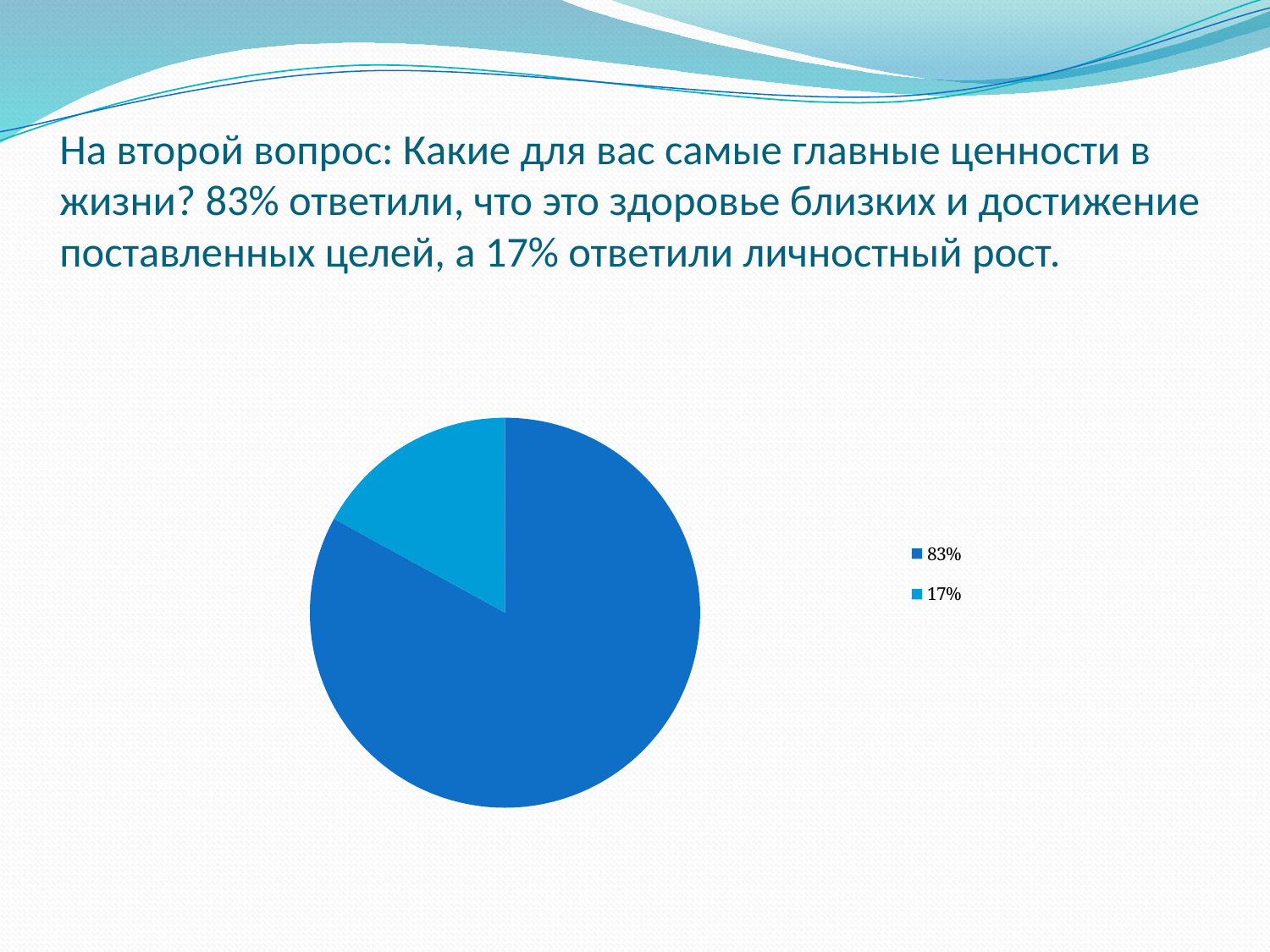
What kind of chart is shown on the slide? pie chart What share of the pie does the light blue slice represent, according to the legend? 17% Which legend entry corresponds to the smallest slice of the pie chart? 17% What are the two entries listed in the legend of the pie chart? 83% and 17% What share of the pie does the dark blue slice represent, according to the legend? 83% What colour is the slice labelled 17% in the pie chart? light blue Which slice is larger: the one labelled 83% or the one labelled 17%? 83% Which legend entry corresponds to the largest slice of the pie chart? 83% What is the difference between the two shares shown in the legend of the pie chart? 66% How many slices does the pie chart have? 2 How many entries does the legend of the pie chart list? 2